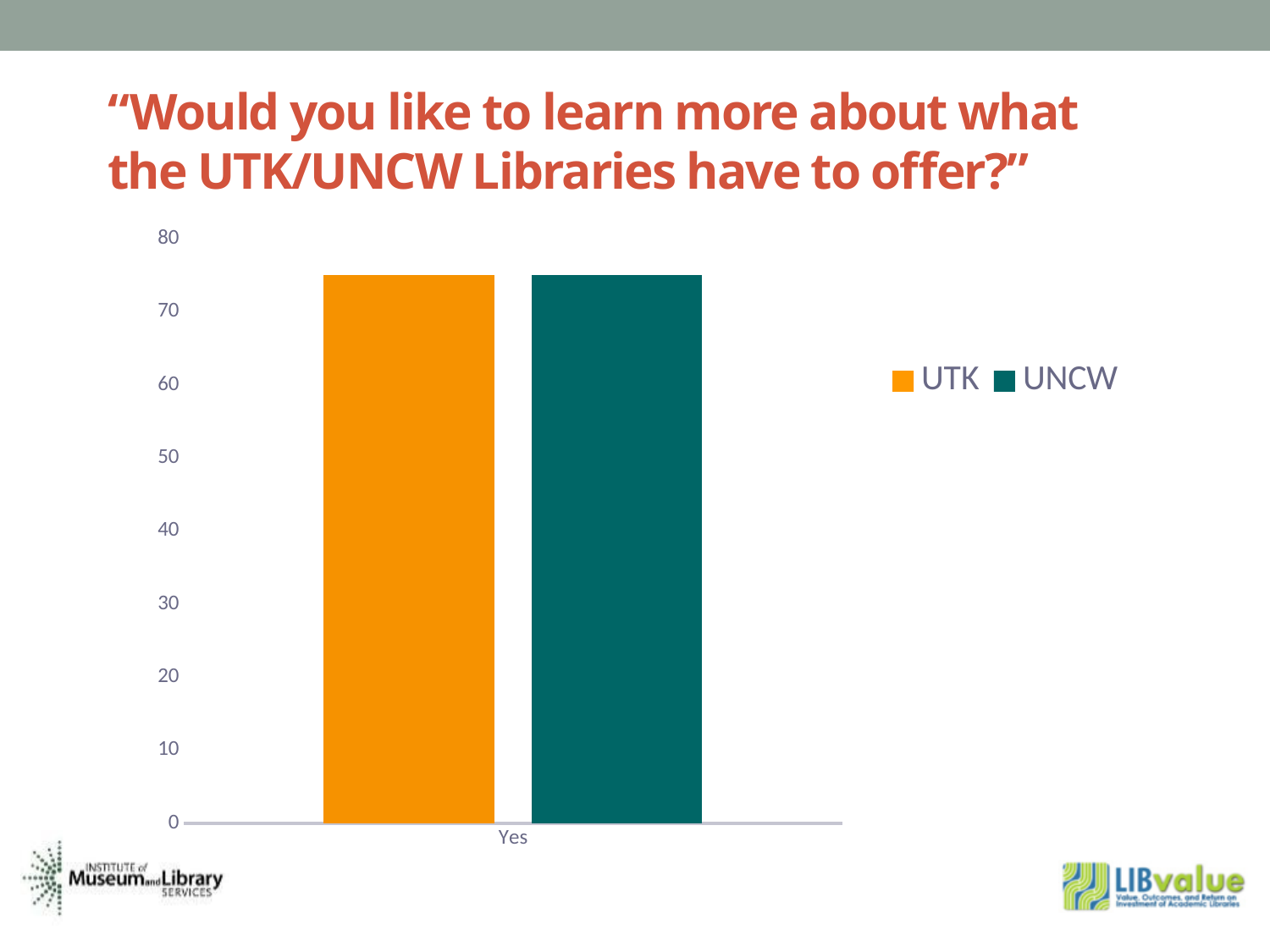
Is the value for UTK greater or less than 70? greater What is the label of the category on the x axis? Yes Is the value for UNCW greater or less than 70? greater Is the value for UNCW greater or less than 50? greater How many series does the legend list? 2 How many categories are shown on the x axis? 1 Which series is shown in orange? UTK What kind of chart is shown on the slide? bar chart